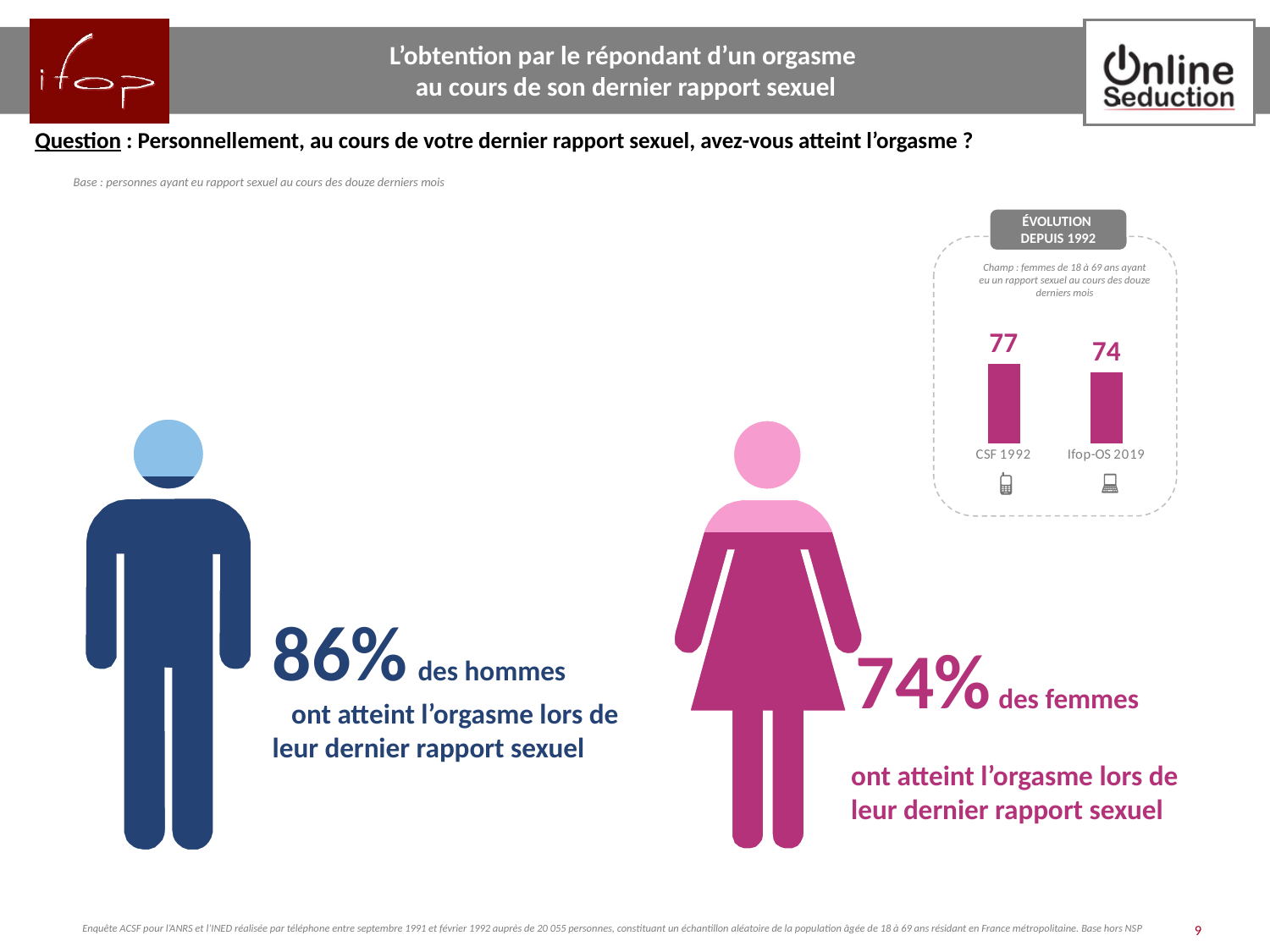
In the 'ÉVOLUTION DEPUIS 1992' chart, what is the difference between the CSF 1992 value and the Ifop-OS 2019 value? 3 What is the title of the small bar chart on the right of the slide? ÉVOLUTION DEPUIS 1992 In the 'ÉVOLUTION DEPUIS 1992' chart, which category has the highest value? CSF 1992 In the 'ÉVOLUTION DEPUIS 1992' chart, which category has the lowest value? Ifop-OS 2019 How many bars are shown in the 'ÉVOLUTION DEPUIS 1992' chart? 2 In the 'ÉVOLUTION DEPUIS 1992' chart, do the values rise or fall from CSF 1992 to Ifop-OS 2019? Fall What colour are the bars in the 'ÉVOLUTION DEPUIS 1992' chart? Magenta/pink What kind of chart is the 'ÉVOLUTION DEPUIS 1992' chart? Bar chart In the 'ÉVOLUTION DEPUIS 1992' chart, what is the value for Ifop-OS 2019? 74 In the 'ÉVOLUTION DEPUIS 1992' chart, which is larger: the value for CSF 1992 or the value for Ifop-OS 2019? CSF 1992 In the 'ÉVOLUTION DEPUIS 1992' chart, what is the value for CSF 1992? 77